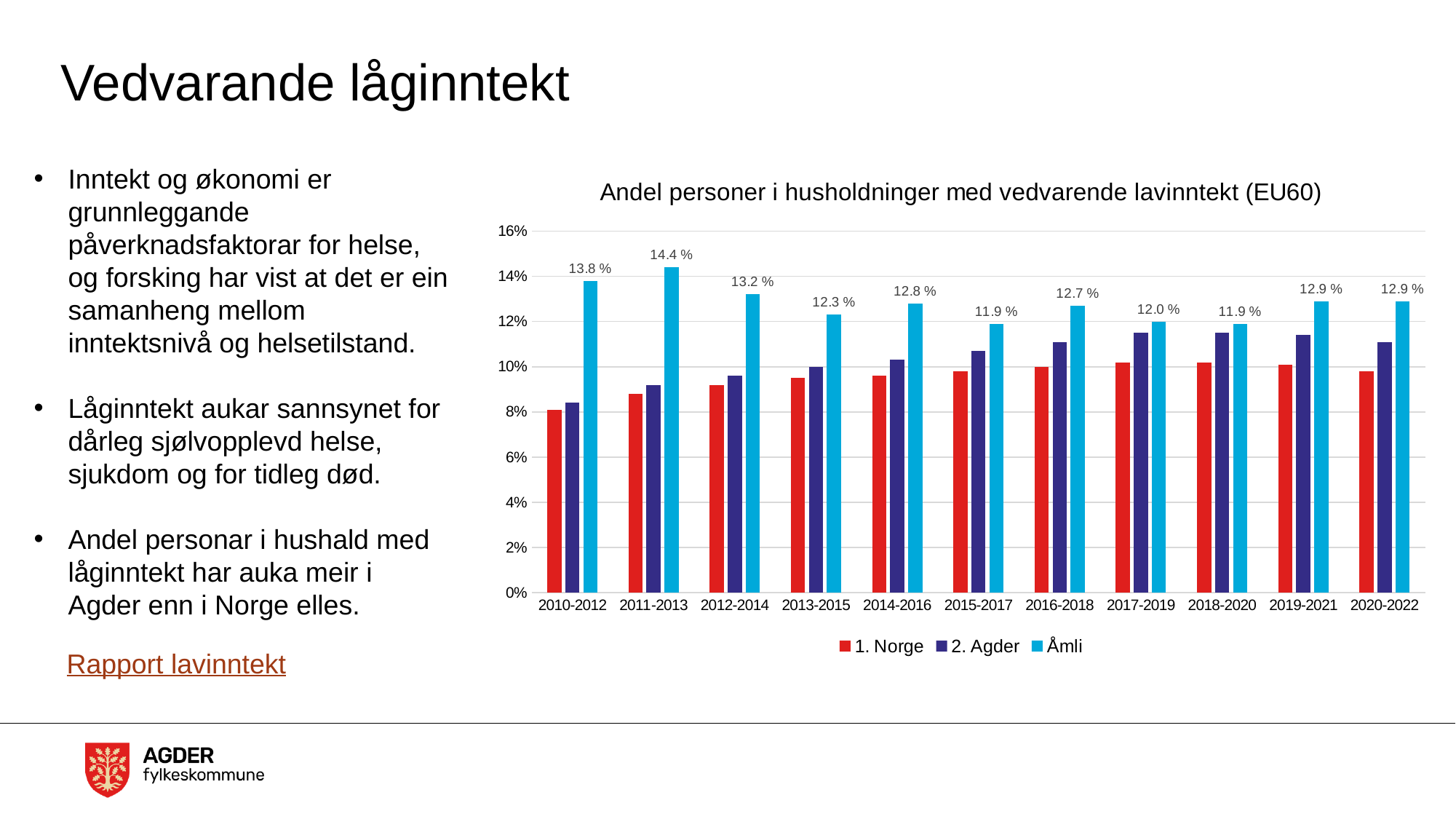
In which period is the Åmli value highest? 2011-2013 What is the lowest value shown for Åmli? 11.9 % What is the value for Åmli in 2013-2015? 12.3 % How many periods are shown on the x axis? 11 What is the difference between the Åmli values for 2011-2013 and 2012-2014? 1.2 % What kind of chart is shown on the slide? bar chart What is the value for Åmli in 2020-2022? 12.9 % Is the value for 1. Norge in 2010-2012 greater or less than 10%? less What is the value for Åmli in 2011-2013? 14.4 % Which is larger for Åmli: the value for 2010-2012 or the value for 2013-2015? 2010-2012 Is the value for 2. Agder in 2019-2021 greater or less than 10%? greater How many series does the legend list? 3